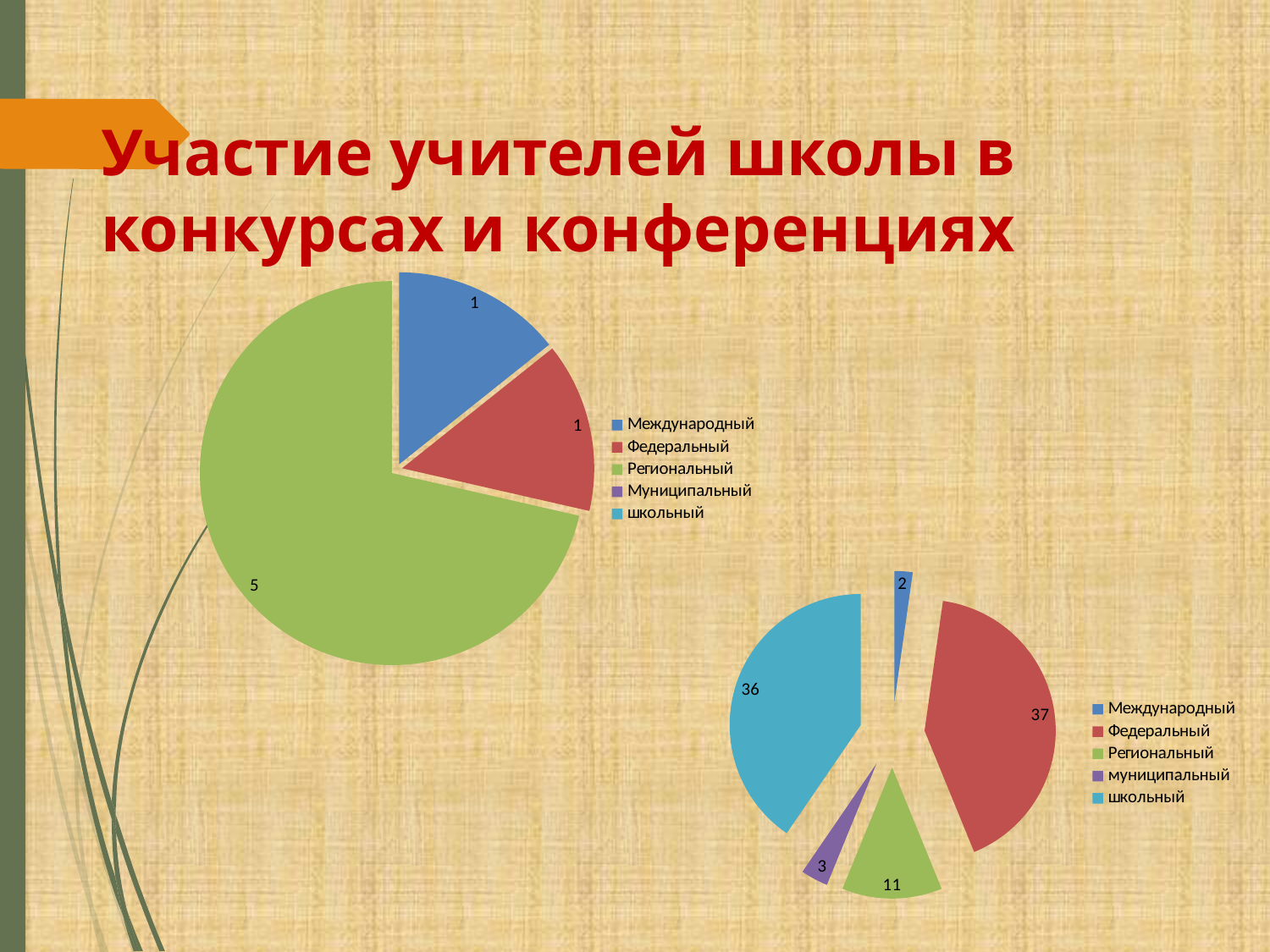
In the lower-right pie chart, what is the value for Федеральный? 37 In the lower-right pie chart, what is the total of all the slice values? 89 How many entries does the legend of the upper-left pie chart list? 5 In the lower-right pie chart, what is the value for Региональный? 11 In the upper-left pie chart, what is the value for Региональный? 5 In the lower-right pie chart, what is the difference between the values for Федеральный and школьный? 1 In the lower-right pie chart, what is the value for школьный? 36 In the upper-left pie chart, which category has the largest slice? Региональный How many slices does the lower-right pie chart have? 5 What kind of chart is the lower-right chart on the slide? pie chart In the lower-right pie chart, which category has the smallest value? Международный In the lower-right pie chart, which is larger: Региональный or муниципальный? Региональный